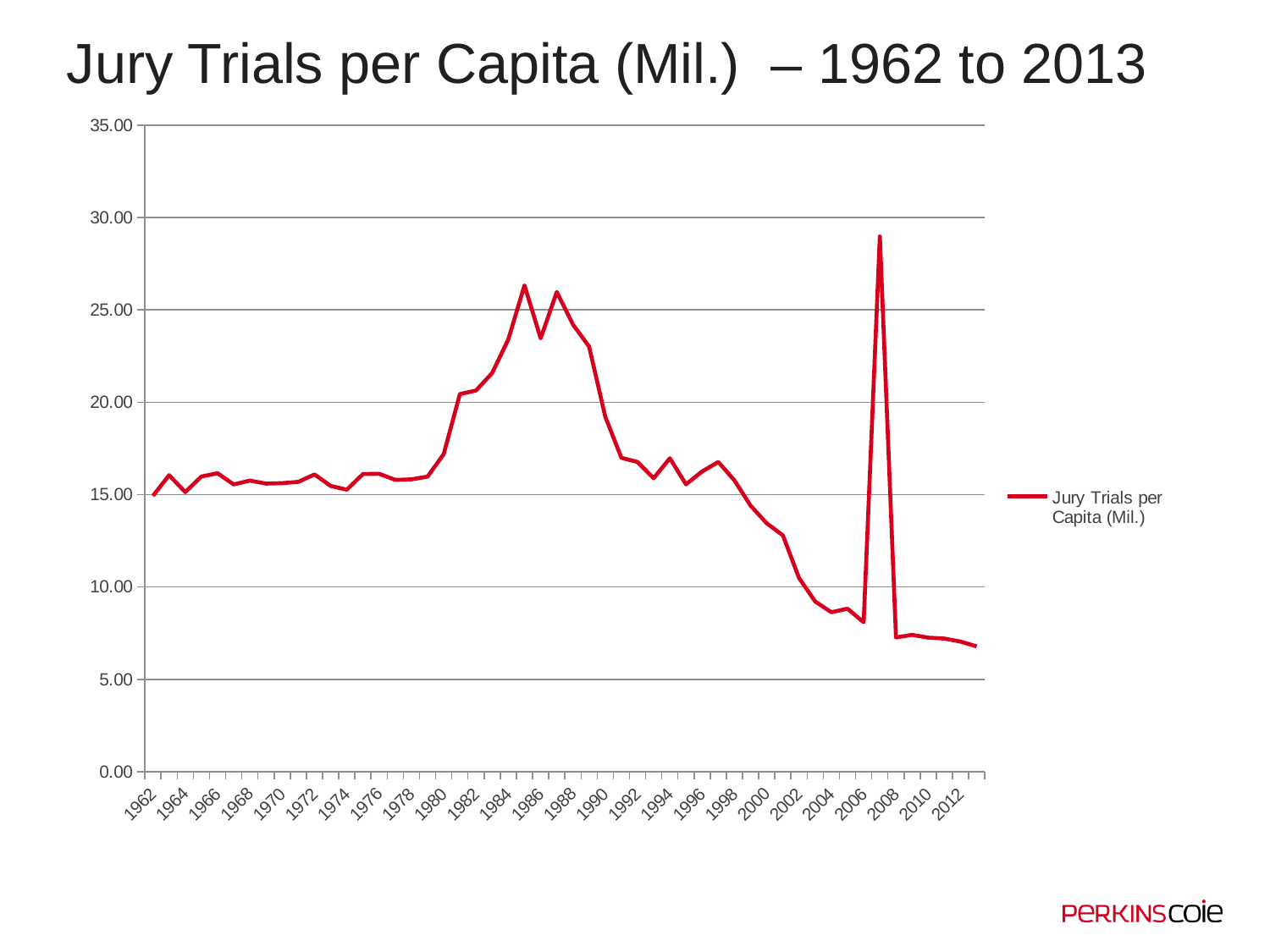
Do the values rise or fall from 2008 to 2013? fall What kind of chart is shown on the slide? line chart Is the value for 2002 greater or less than 15.00? less In which year does the line reach its highest value? 2007 What is the title of the chart? Jury Trials per Capita (Mil.) – 1962 to 2013 Is the value for 1985 greater or less than 25.00? greater Which year has the larger value, 1985 or 2000? 1985 Do the values rise or fall from 1980 to 1985? rise How many series does the legend list? 1 Is the value for 2013 greater or less than 10.00? less In which year does the line reach its lowest value? 2013 What is the legend entry for the plotted line? Jury Trials per Capita (Mil.)